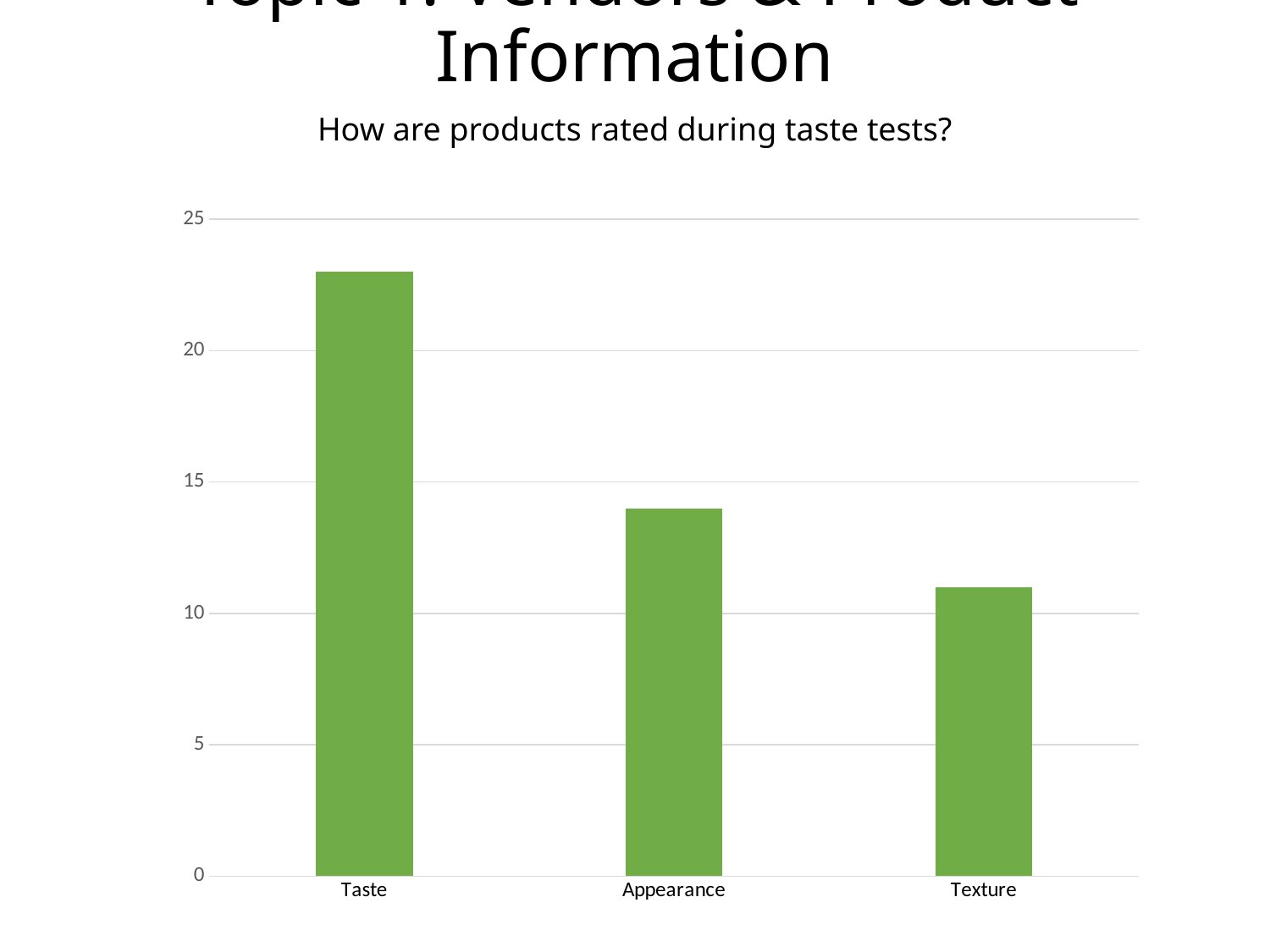
Is the value for Texture greater or less than 15? less Do the bar values rise or fall from left to right across the x axis? fall Is the value for Taste greater or less than 20? greater Which is larger, the value for Taste or the value for Appearance? Taste Which category has the lowest bar? Texture Which category has the highest bar? Taste What is the title of the chart? How are products rated during taste tests? Is the value for Appearance greater or less than 15? less Which is larger, the value for Appearance or the value for Texture? Appearance How many categories are shown on the x axis of the chart? 3 What kind of chart is shown on the slide? bar chart What colour are the bars in the chart? green